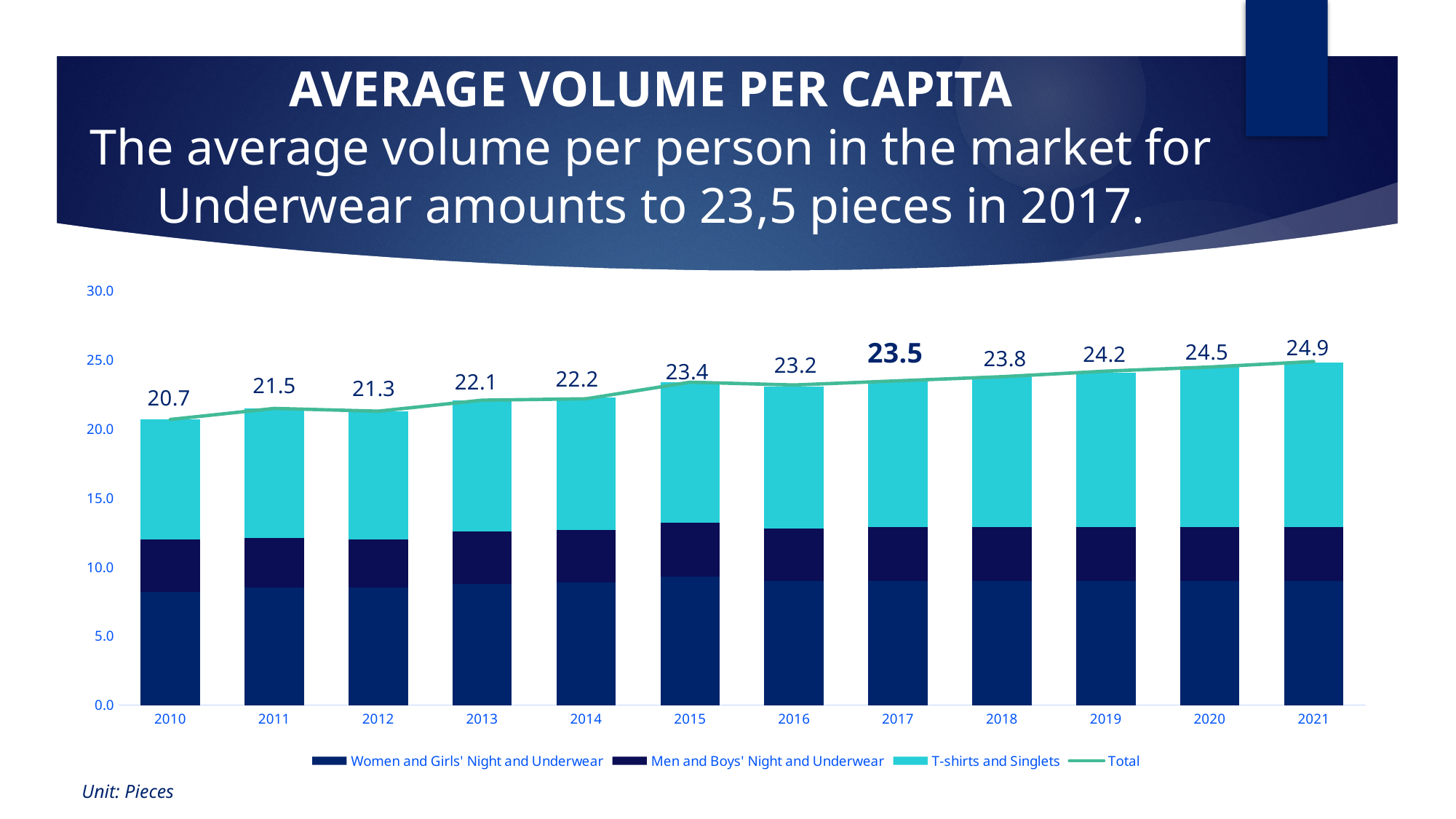
How many series does the legend list? 4 Which year has the lowest Total value? 2010 Which year has the highest Total value? 2021 What is the difference between the Total values for 2021 and 2010? 4.2 What unit is stated below the chart? Pieces What is the Total value for 2017? 23.5 How many years are shown on the x axis? 12 What is the Total value for 2021? 24.9 Is the value for Women and Girls' Night and Underwear in 2010 greater or less than 10.0? less Which year has a larger Total value, 2015 or 2016? 2015 What kind of chart is shown on the slide? Stacked bar chart with a line What is the Total value for 2010? 20.7